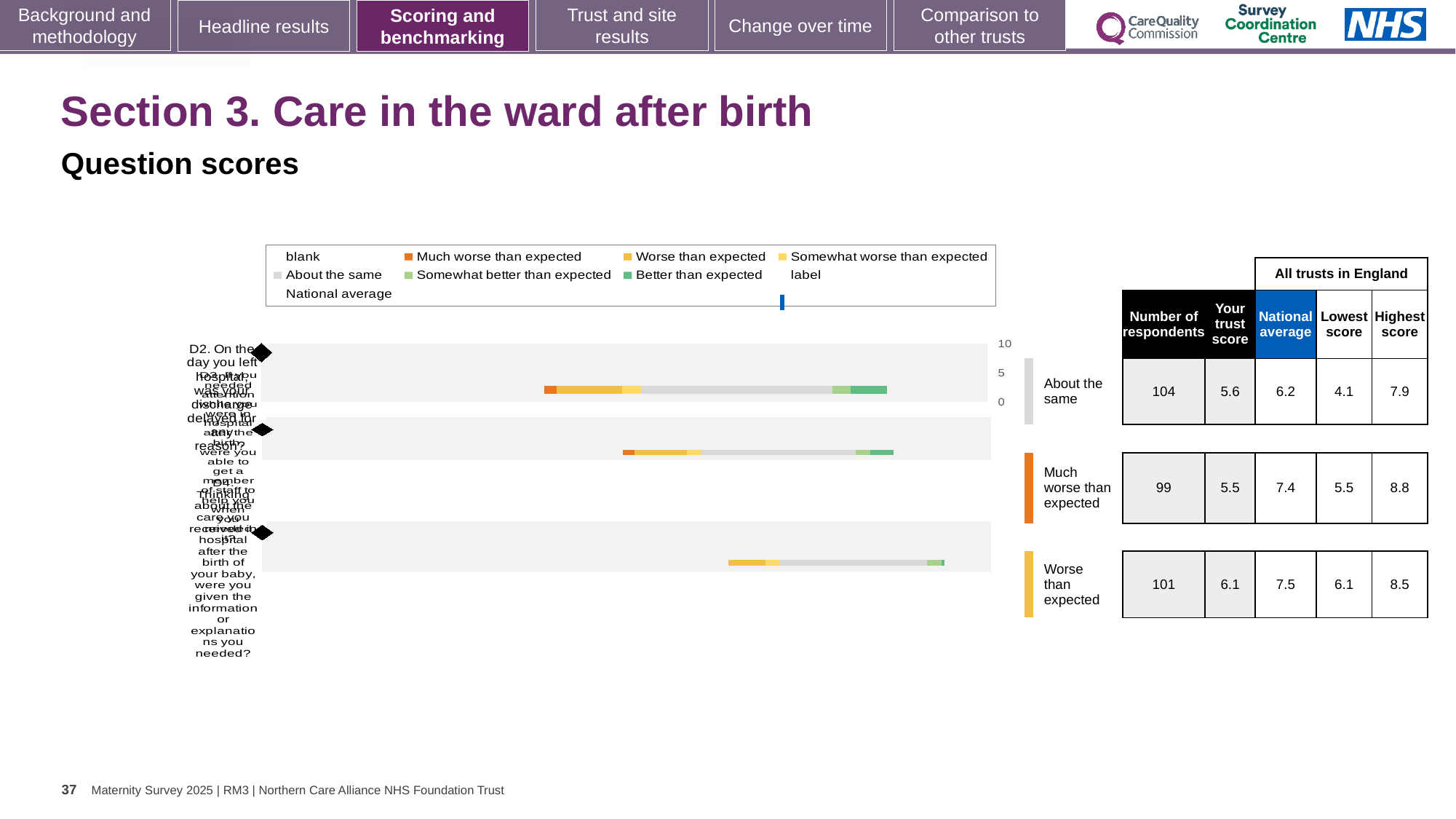
In the table beside the chart, what is the Highest score for the row labelled 'Much worse than expected'? 8.8 In the table beside the chart, what is the 'Your trust score' for the row labelled 'About the same'? 5.6 What kind of chart is shown on the slide? bar chart In the table beside the chart, what is the Number of respondents for the row labelled 'Worse than expected'? 101 In the table beside the chart, which row has the highest Number of respondents? About the same In the table beside the chart, which is larger for the row labelled 'Worse than expected': Your trust score or the National average? National average In the table beside the chart, what is the National average for the row labelled 'Much worse than expected'? 7.4 In the table beside the chart, what is the Lowest score for the row labelled 'About the same'? 4.1 In the table beside the chart, what is the difference between the National average and Your trust score for the row labelled 'Much worse than expected'? 1.9 What colour represents 'Better than expected' in the chart legend? green What colour represents 'Much worse than expected' in the chart legend? orange How many bars are plotted in the chart? 3